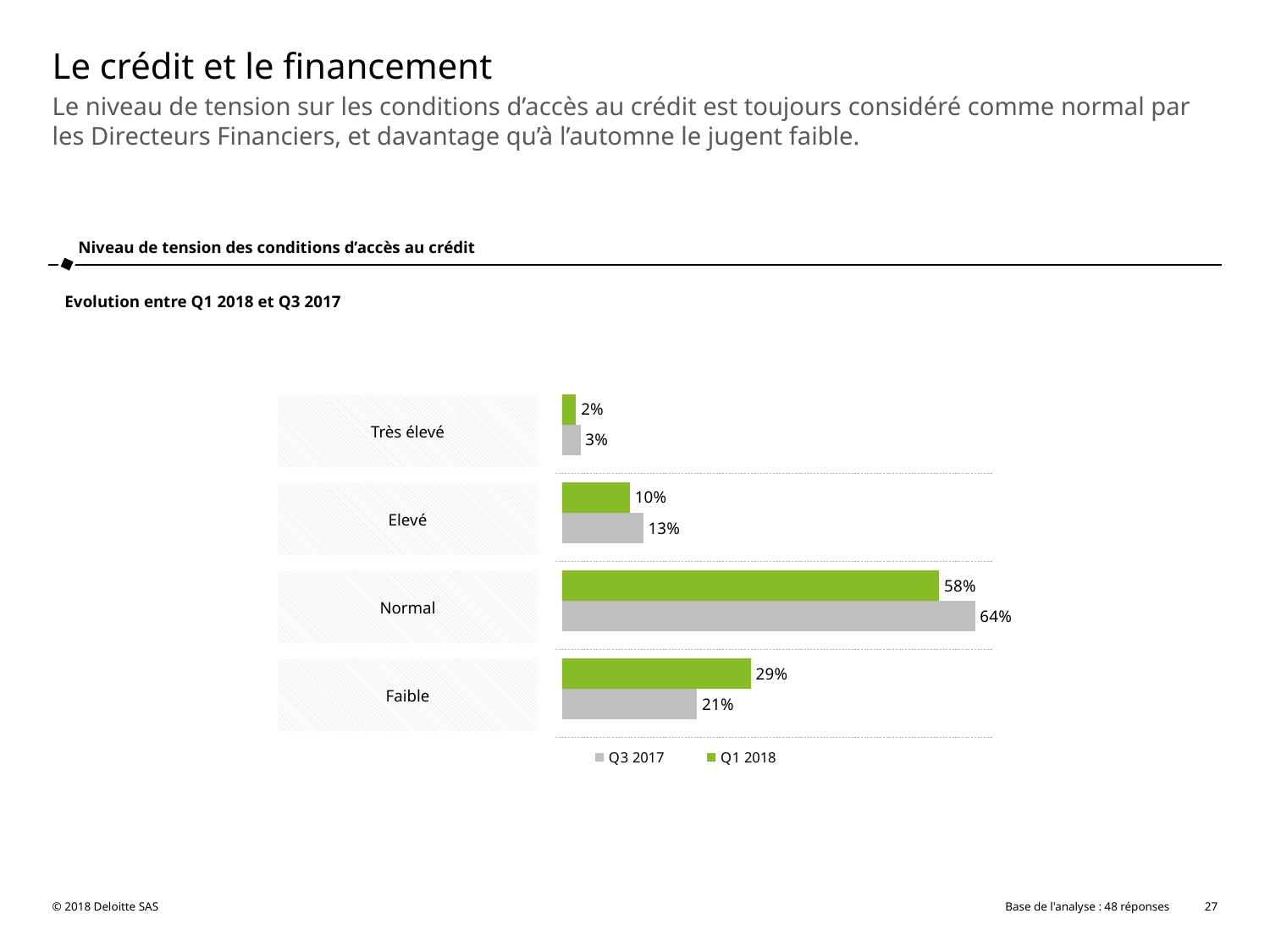
Which is larger for Faible: the Q1 2018 value or the Q3 2017 value? Q1 2018 What is the Q1 2018 value for Très élevé? 2% Which category has the highest Q3 2017 value? Normal What is the Q3 2017 value for Faible? 21% What is the Q3 2017 value for Elevé? 13% Which colour represents the Q1 2018 series? Green Which category has the lowest Q1 2018 value? Très élevé What is the Q1 2018 value for Normal? 58% What kind of chart is shown on the slide? Bar chart How many categories are shown in the chart? 4 What is the difference between the Q3 2017 and Q1 2018 values for Normal? 6% How many series does the legend list? 2